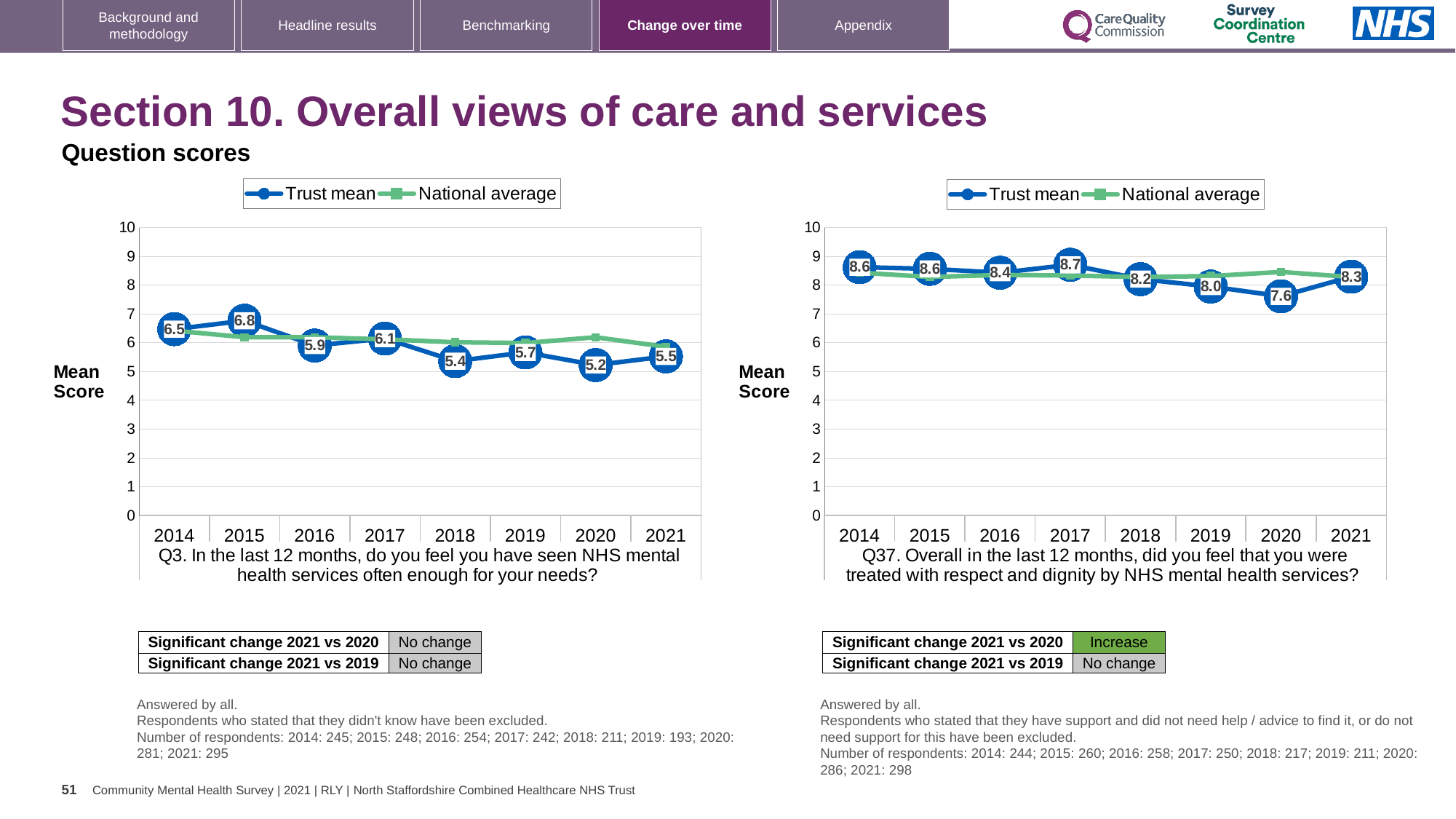
In the left chart (Q3), which year has the lowest Trust mean score? 2020 In the left chart (Q3), what is the Trust mean score for 2015? 6.8 In the right chart (Q37), what is the Trust mean score for 2017? 8.7 In the left chart (Q3), which year has the highest Trust mean score? 2015 In the left chart (Q3), what is the difference between the Trust mean scores for 2015 and 2020? 1.6 In the right chart (Q37), which year has the lowest Trust mean score? 2020 How many series does the legend of the right chart (Q37) list? 2 In the right chart (Q37), what is the difference between the Trust mean scores for 2021 and 2020? 0.7 In the left chart (Q3), what is the Trust mean score for 2021? 5.5 In the right chart (Q37), is the Trust mean score for 2021 higher or lower than for 2020? higher In the right chart (Q37), what is the Trust mean score for 2020? 7.6 How many years are shown on the x axis of the left chart (Q3)? 8